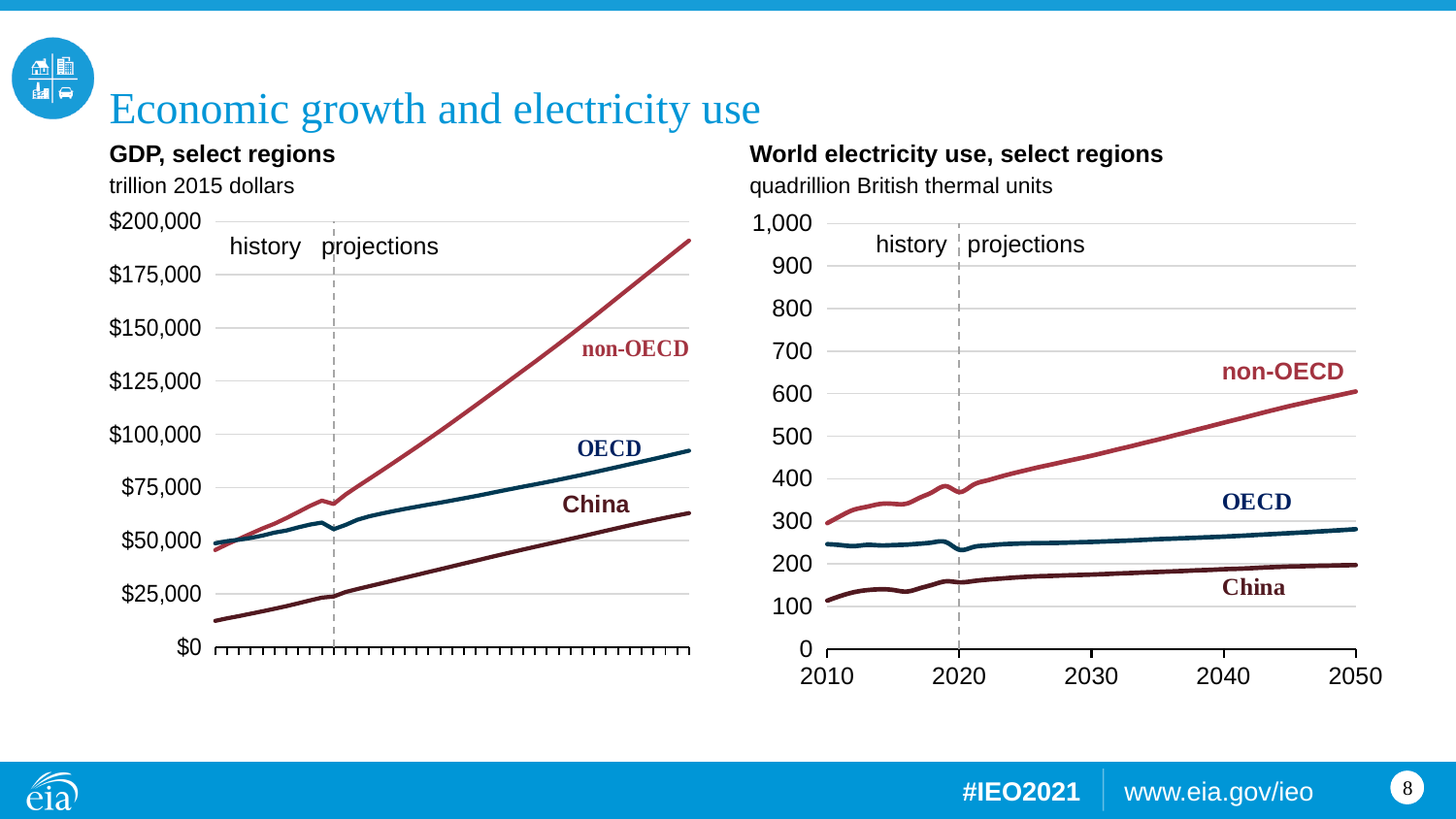
In the 'World electricity use, select regions' chart, which region has the highest electricity use in 2050? non-OECD In the 'World electricity use, select regions' chart, is the OECD value in 2050 greater or less than 300? less What kind of chart is the 'World electricity use, select regions' chart? line chart What kind of chart is the 'GDP, select regions' chart? line chart In the 'World electricity use, select regions' chart, which region has the lowest electricity use in 2050? China In the 'GDP, select regions' chart, is the non-OECD value at the end of the projection period greater or less than $175,000? greater In the 'GDP, select regions' chart, how many series (regions) are plotted? 3 In the 'GDP, select regions' chart, is the OECD value at the end of the projection period greater or less than $100,000? less In the 'World electricity use, select regions' chart, does the non-OECD line rise or fall from 2020 to 2050? rise What unit is used on the 'World electricity use, select regions' chart? quadrillion British thermal units In the 'GDP, select regions' chart, which region has the highest GDP at the end of the projection period? non-OECD